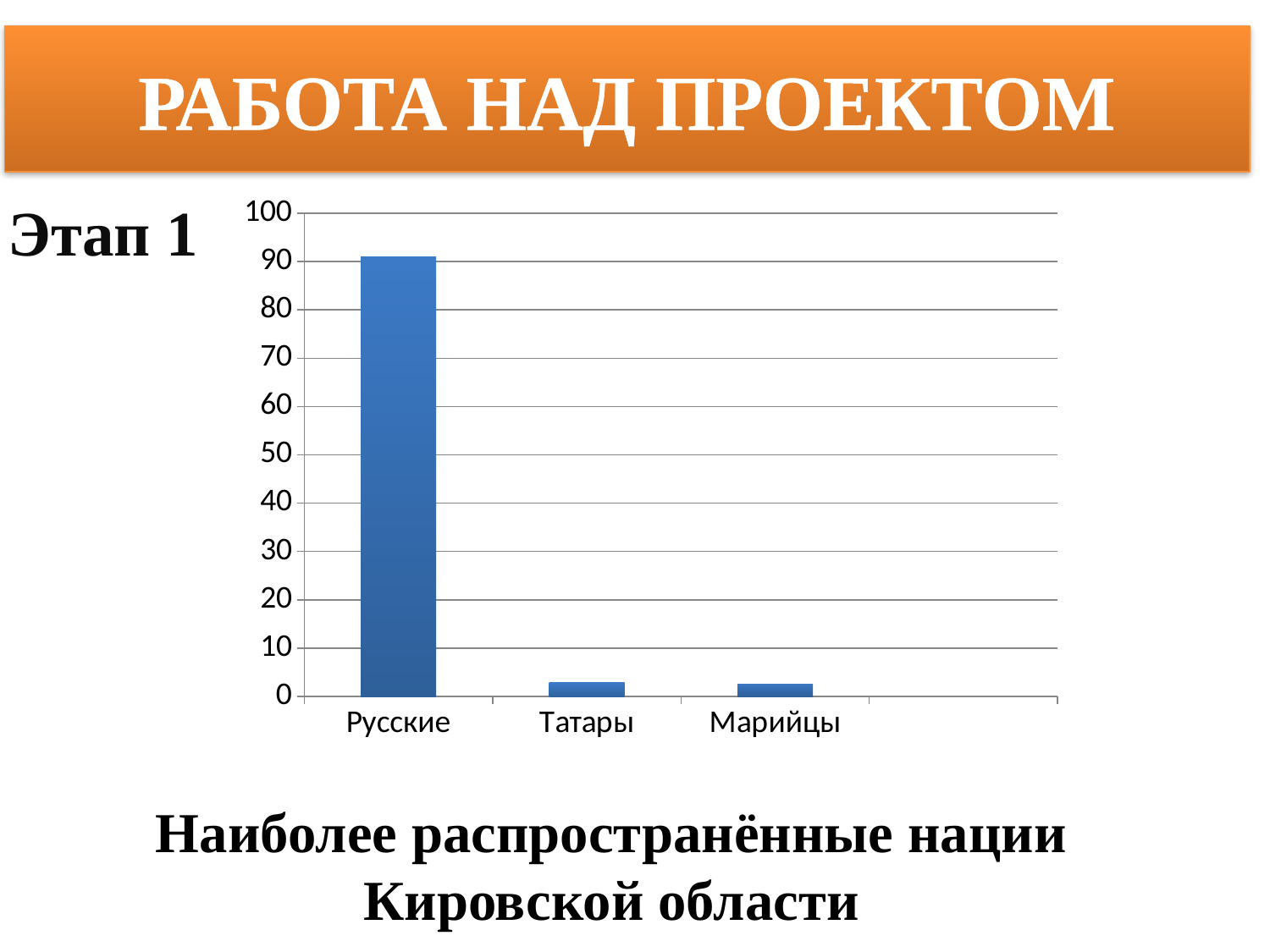
Do the bar values rise or fall from left to right along the x axis? fall Is the value for Татары greater or less than 10? less What is the highest value shown on the vertical axis of the chart? 100 Is the value for Русские greater or less than 80? greater How many categories are shown on the x axis of the chart? 3 What kind of chart is shown on the slide? bar chart Which category has the highest bar in the chart? Русские Which is larger, the value for Марийцы or the value for Русские? Русские Which is larger, the value for Русские or the value for Татары? Русские What caption is written below the chart? Наиболее распространённые нации Кировской области Is the value for Марийцы greater or less than 10? less